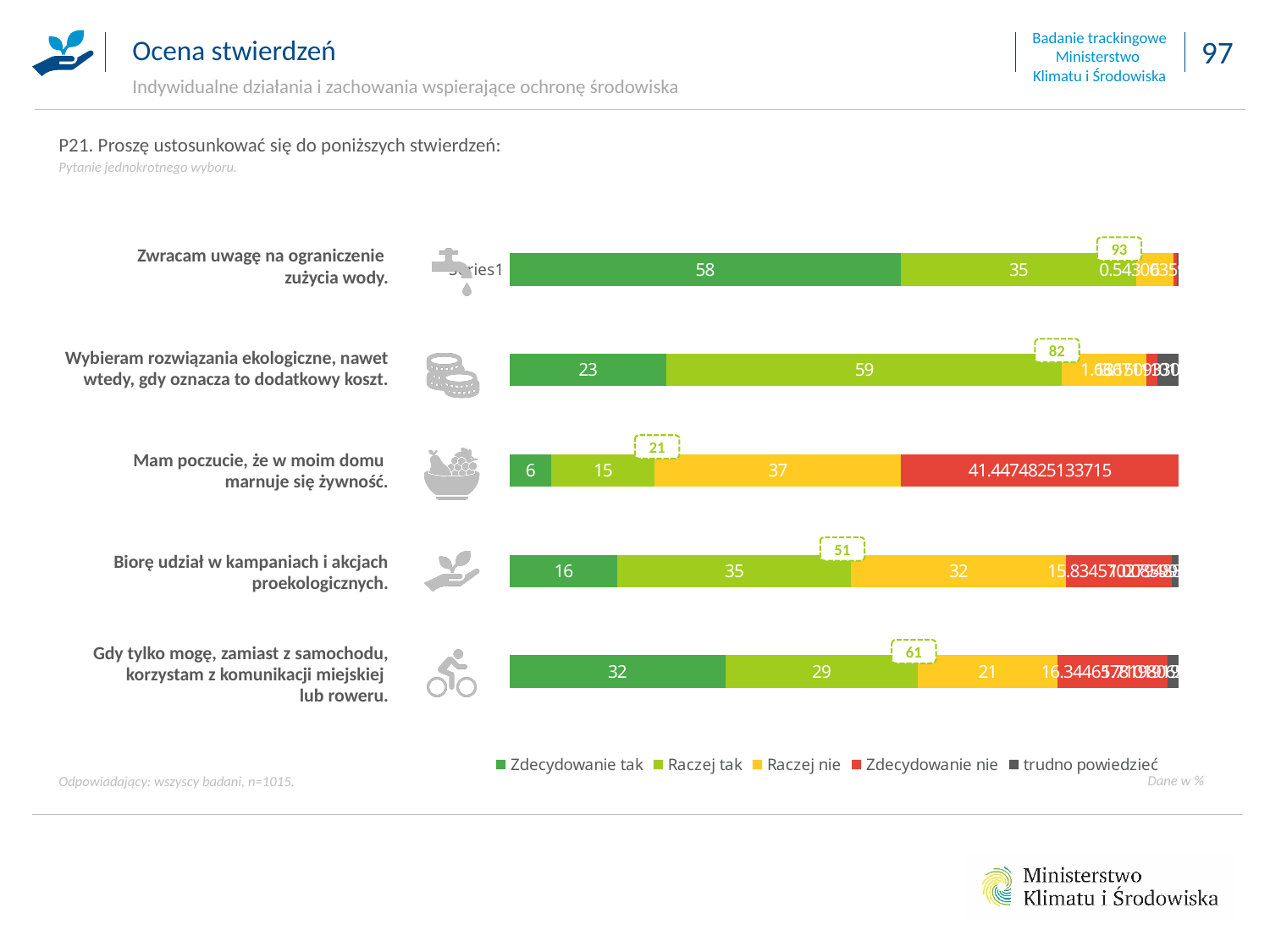
What is the 'Zdecydowanie tak' value for 'Gdy tylko mogę, zamiast z samochodu, korzystam z komunikacji miejskiej lub roweru.'? 32 How many statements (categories) are plotted in the chart? 5 What is the difference between the 'Zdecydowanie tak' value for 'Zwracam uwagę na ograniczenie zużycia wody.' and for 'Wybieram rozwiązania ekologiczne, nawet wtedy, gdy oznacza to dodatkowy koszt.'? 35 Which statement has the lowest 'Zdecydowanie tak' value? Mam poczucie, że w moim domu marnuje się żywność. What is the 'Zdecydowanie tak' value for 'Zwracam uwagę na ograniczenie zużycia wody.'? 58 Which is larger: the 'Raczej tak' value for 'Biorę udział w kampaniach i akcjach proekologicznych.' or the 'Raczej tak' value for 'Gdy tylko mogę, zamiast z samochodu, korzystam z komunikacji miejskiej lub roweru.'? Biorę udział w kampaniach i akcjach proekologicznych. What is the 'Raczej tak' value for 'Wybieram rozwiązania ekologiczne, nawet wtedy, gdy oznacza to dodatkowy koszt.'? 59 How many series does the legend list? 5 What kind of chart is shown on the slide? stacked bar chart Which statement has the highest 'Zdecydowanie tak' value? Zwracam uwagę na ograniczenie zużycia wody. What is the value shown in the dashed box above the bar for 'Biorę udział w kampaniach i akcjach proekologicznych.'? 51 What is the 'Raczej nie' value for 'Mam poczucie, że w moim domu marnuje się żywność.'? 37